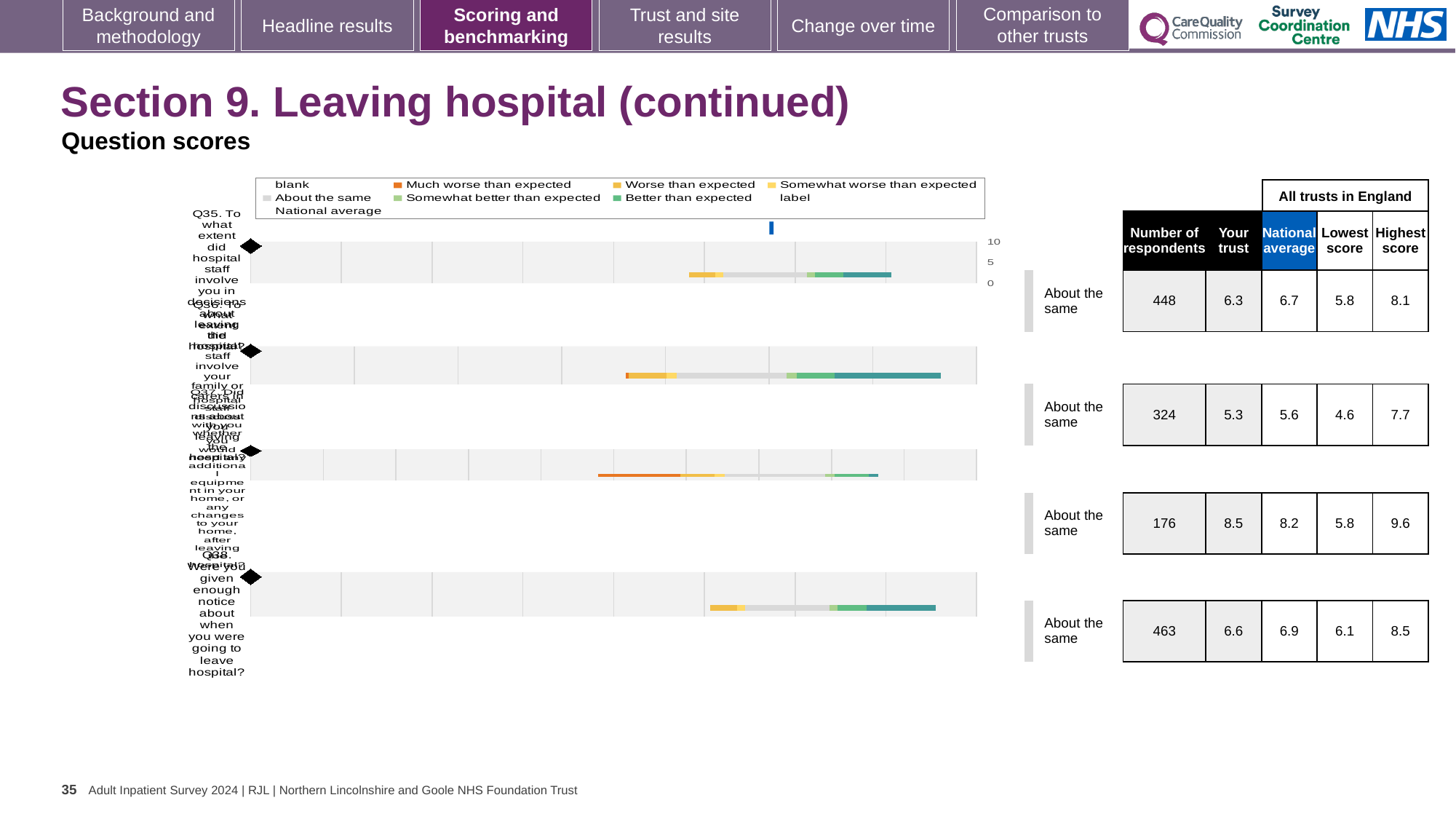
Which question has the highest 'Your trust' score? the third question from the top (8.5) Which question has the lowest 'Your trust' score? the second question from the top (5.3) What is the highest score among all trusts in England for the second question from the top? 7.7 What is the number of respondents for the third question from the top? 176 What is the national average for the bottom question, Q38? 6.9 What kind of chart is used to show the question scores on this slide? bar chart What is the difference between the highest score and the lowest score for Q38? 2.4 For Q35, which is larger: the trust's score or the national average? the national average What benchmark category is shown for every question on this slide? About the same Which colour does the legend use for 'Much worse than expected'? orange How many questions (bars) are plotted in the chart? 4 What is the 'Your trust' score for the top question, Q35? 6.3